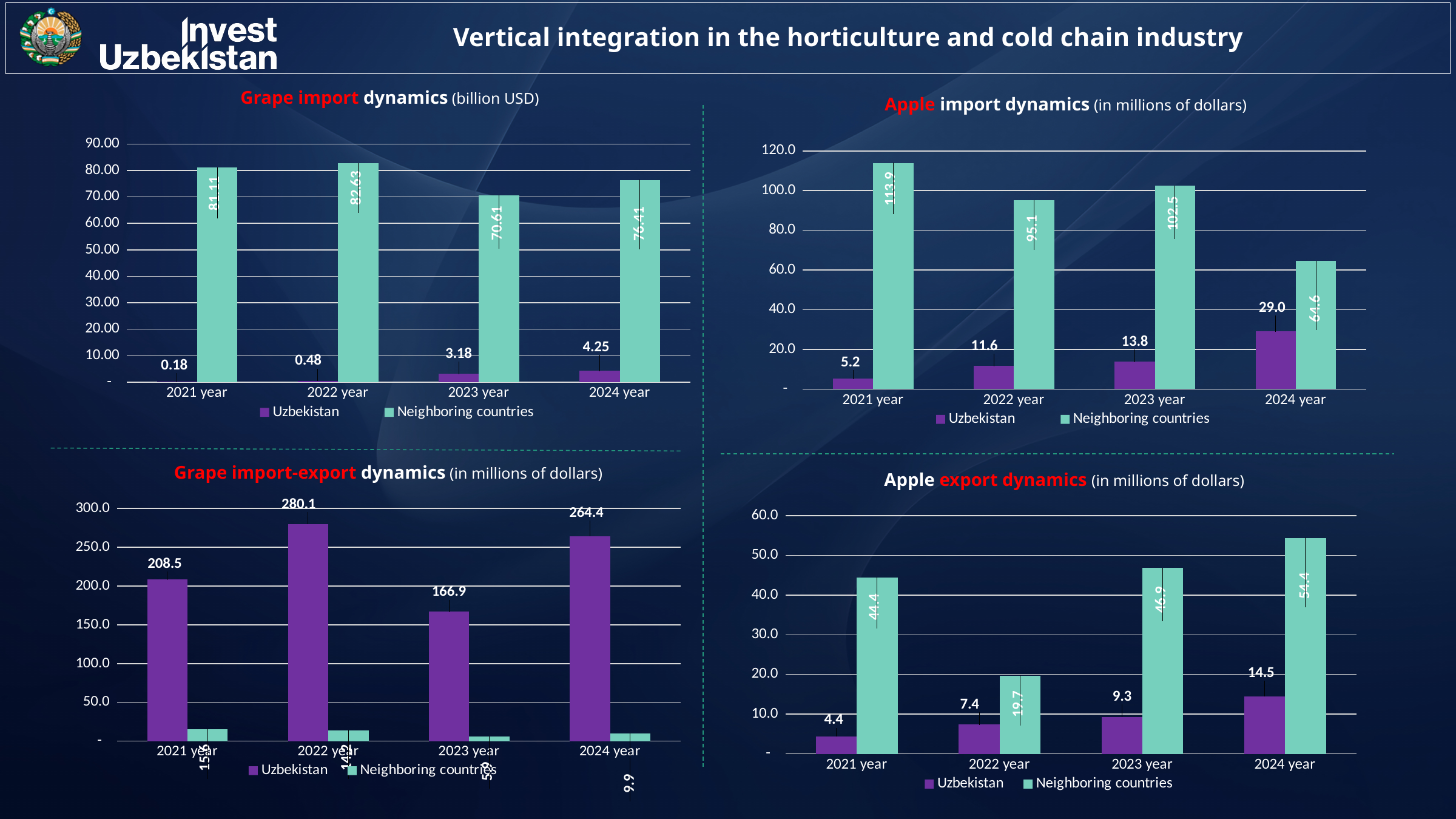
In the Apple export dynamics chart, which is larger: the Neighboring countries value for 2021 year or for 2022 year? 2021 year In the Grape import-export dynamics chart, which year has the lowest value for Uzbekistan? 2023 year In the Grape import-export dynamics chart, what is the value for Uzbekistan in 2022 year? 280.1 In the Grape import dynamics chart, what is the value for Uzbekistan in 2024 year? 4.25 In the Apple import dynamics chart, what is the value for Neighboring countries in 2021 year? 113.9 In the Grape import dynamics chart, what is the difference between the Neighboring countries values for 2022 year and 2023 year? 12.02 In the Apple import dynamics chart, which year has the lowest value for Neighboring countries? 2024 year In the Apple export dynamics chart, what is the value for Neighboring countries in 2024 year? 54.4 In the Grape import dynamics chart, which year has the highest value for Neighboring countries? 2022 year In the Apple export dynamics chart, what is the difference between the Uzbekistan values for 2024 year and 2021 year? 10.1 How many series does the legend of the Apple export dynamics chart list? 2 In the Apple import dynamics chart, do the Uzbekistan values rise or fall from 2021 year to 2024 year? rise